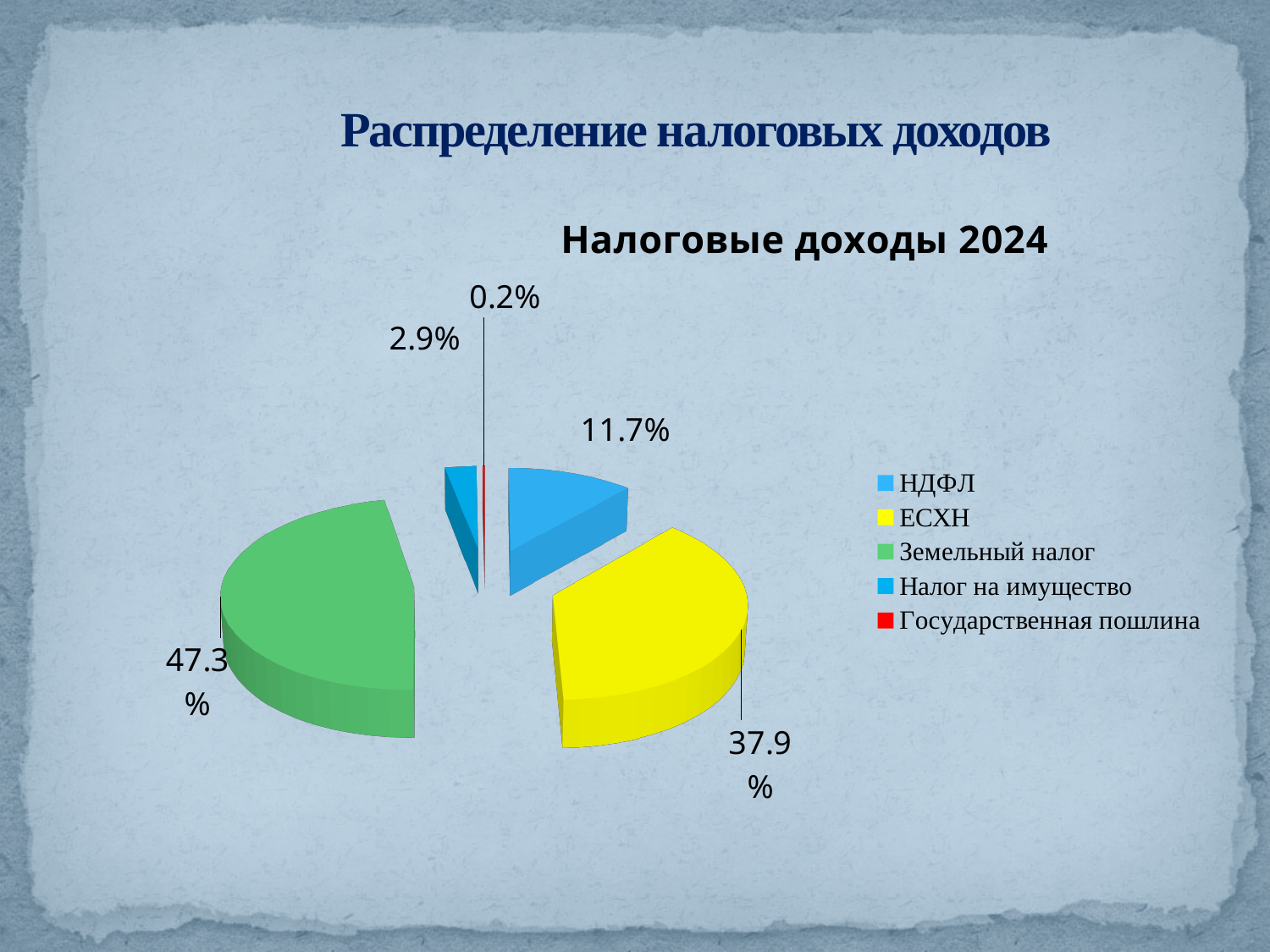
What is the value shown for НДФЛ? 11.7% Which is larger, the share of НДФЛ or the share of Налог на имущество? НДФЛ What share of the pie does Земельный налог have? 47.3% What is the difference between the shares of Земельный налог and ЕСХН? 9.4% What is the value shown for Налог на имущество? 2.9% How many categories does the legend list? 5 What type of chart is shown on the slide? Pie chart Which category has the smallest share of the pie? Государственная пошлина What is the value shown for Государственная пошлина? 0.2% Which category has the largest share of the pie? Земельный налог What share of the pie does ЕСХН have? 37.9% What is the title of the chart? Налоговые доходы 2024